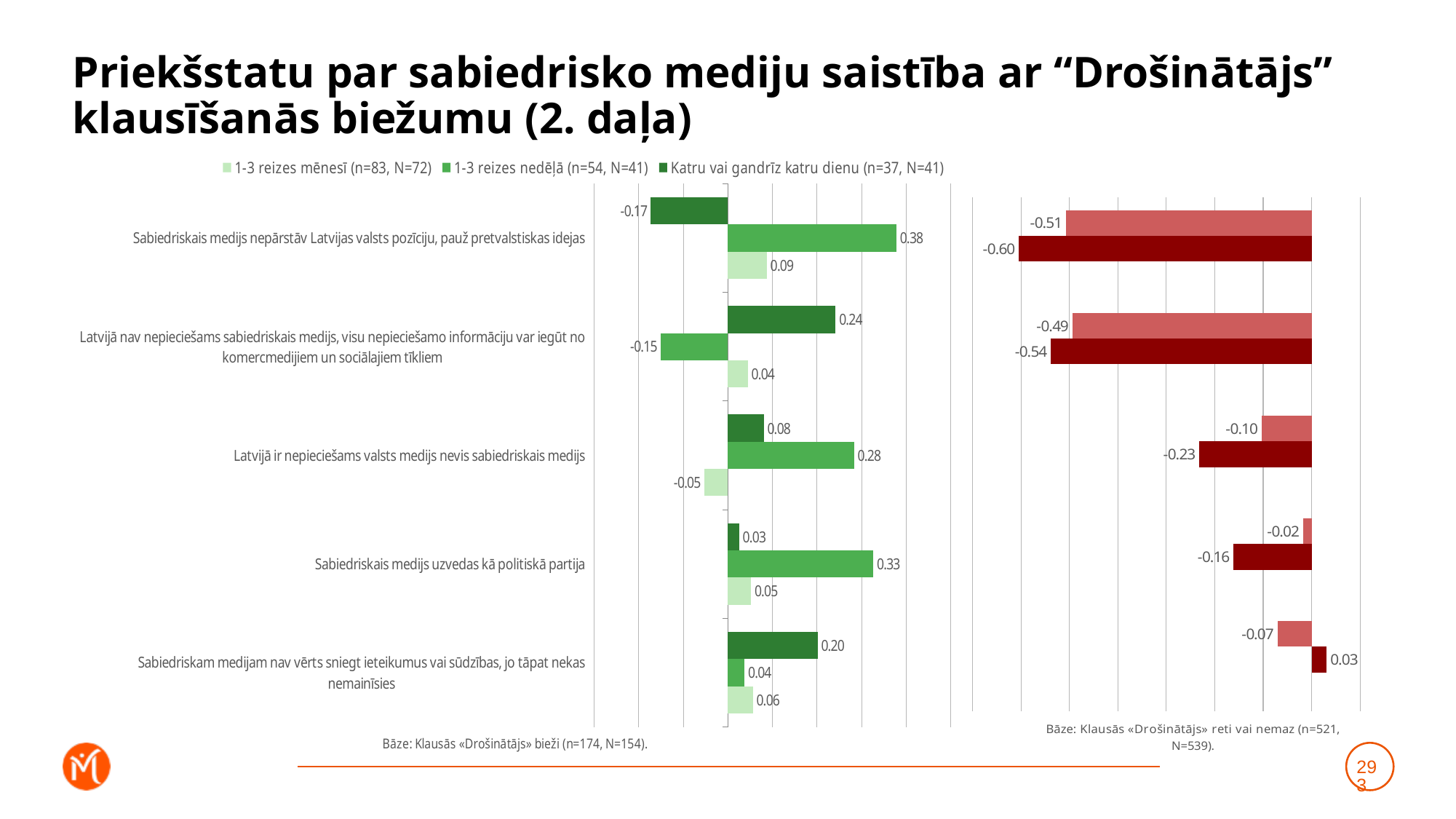
On the left chart, what is the value for "Katru vai gandrīz katru dienu" for "Sabiedriskam medijam nav vērts sniegt ieteikumus vai sūdzības, jo tāpat nekas nemainīsies"? 0.20 On the left chart, which statement has the lowest value for "Katru vai gandrīz katru dienu"? Sabiedriskais medijs nepārstāv Latvijas valsts pozīciju, pauž pretvalstiskas idejas How many statement categories are shown on the left chart? 5 On the left chart, which statement has the highest value for "1-3 reizes nedēļā"? Sabiedriskais medijs nepārstāv Latvijas valsts pozīciju, pauž pretvalstiskas idejas On the left chart, for "Latvijā nav nepieciešams sabiedriskais medijs, visu nepieciešamo informāciju var iegūt no komercmedijiem un sociālajiem tīkliem", which series has the larger value: "Katru vai gandrīz katru dienu" or "1-3 reizes mēnesī"? Katru vai gandrīz katru dienu On the left chart, what is the value for "1-3 reizes nedēļā" for "Sabiedriskais medijs uzvedas kā politiskā partija"? 0.33 How many series does the legend list for the left chart? 3 What kind of chart is the left chart? Bar chart What base text is shown under the left chart? Bāze: Klausās «Drošinātājs» bieži (n=174, N=154). On the right chart, what is the lowest value shown? -0.60 On the left chart, what is the value for "1-3 reizes mēnesī" for "Latvijā ir nepieciešams valsts medijs nevis sabiedriskais medijs"? -0.05 On the left chart, for "Sabiedriskais medijs nepārstāv Latvijas valsts pozīciju, pauž pretvalstiskas idejas", what is the difference between the "1-3 reizes nedēļā" value and the "1-3 reizes mēnesī" value? 0.29